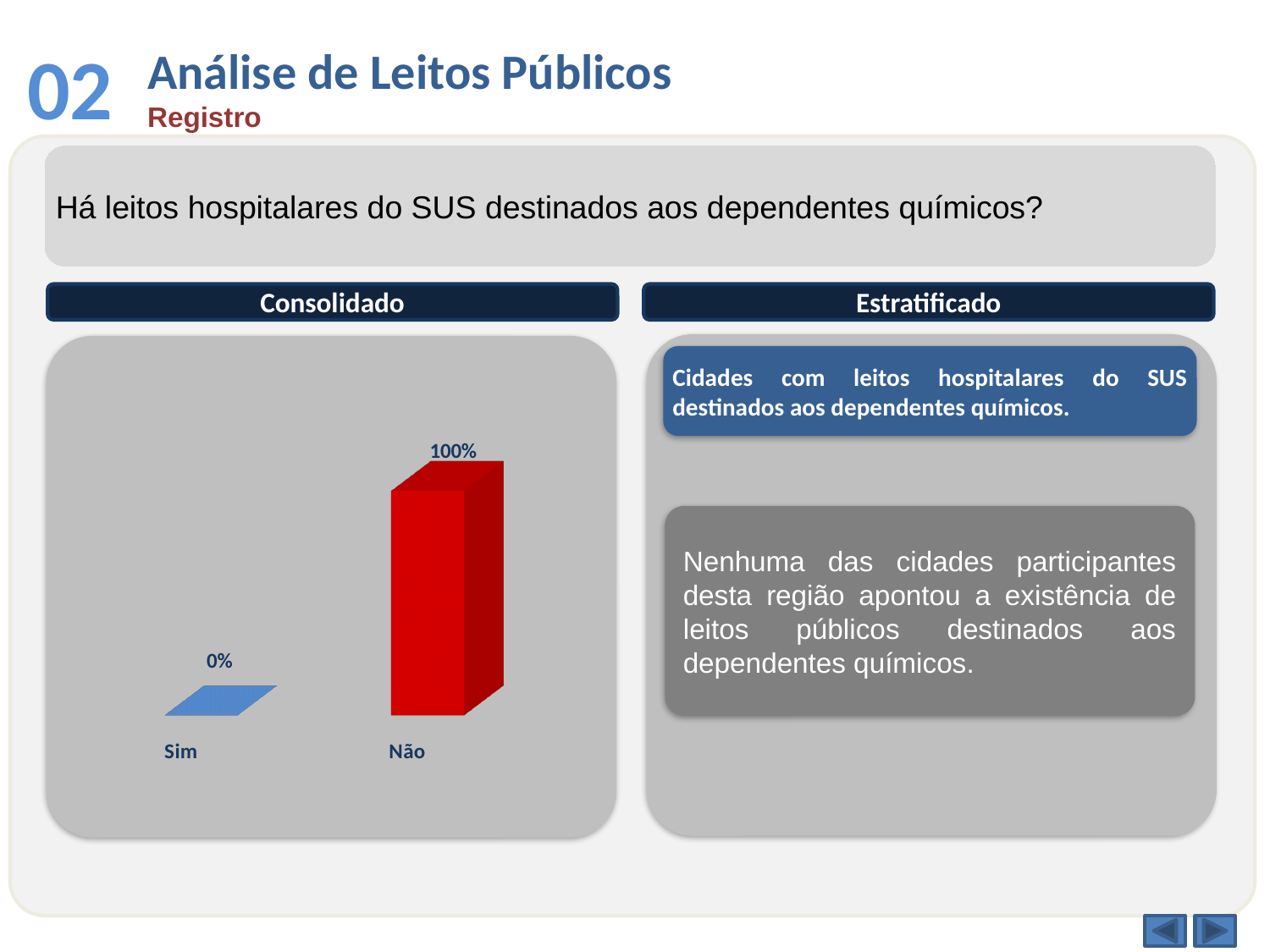
Do the values rise or fall from "Sim" to "Não"? rise What is the difference between the values for "Não" and "Sim"? 100% Which category has the lowest value in the chart? Sim What kind of chart is shown on the slide? bar chart What colour is the bar for "Não"? red Which category has the highest value in the chart? Não Which is larger, the value for "Sim" or the value for "Não"? Não How many categories are shown in the chart? 2 What is the value for "Sim" in the chart? 0% Under which heading does the chart appear on the slide? Consolidado What is the value for "Não" in the chart? 100% What is the total of the values for "Sim" and "Não"? 100%